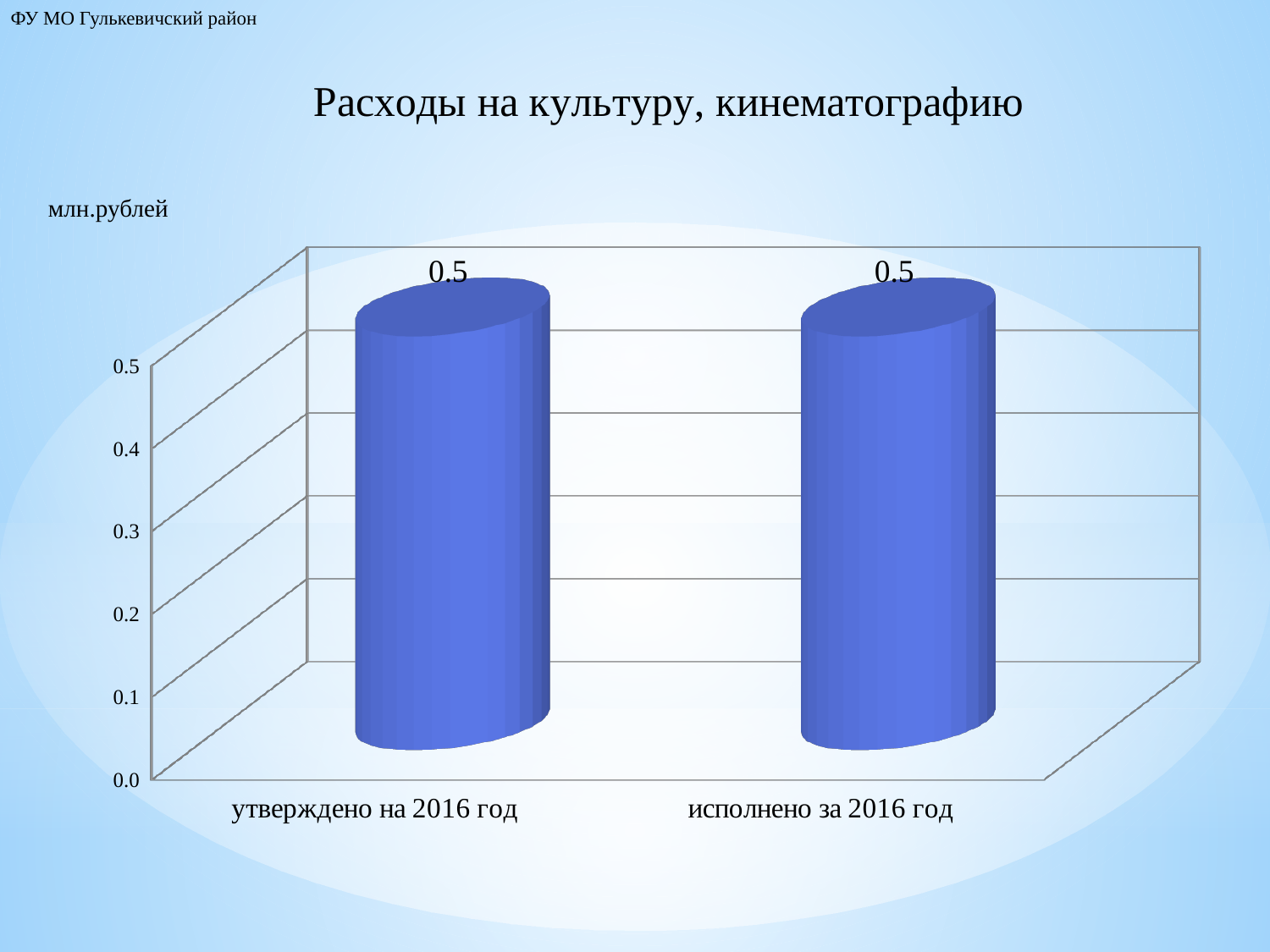
What is the value for 'утверждено на 2016 год'? 0.5 What kind of chart is shown on the slide? bar chart What is the difference between the value for 'утверждено на 2016 год' and the value for 'исполнено за 2016 год'? 0.0 Do the values rise, fall or stay the same from 'утверждено на 2016 год' to 'исполнено за 2016 год'? stay the same Is the value for 'утверждено на 2016 год' greater or less than 0.3? greater Is the value for 'исполнено за 2016 год' greater or less than 0.4? greater What is the title of the chart? Расходы на культуру, кинематографию In what units are the values on the chart expressed? млн.рублей How many categories are shown on the chart? 2 What is the value for 'исполнено за 2016 год'? 0.5